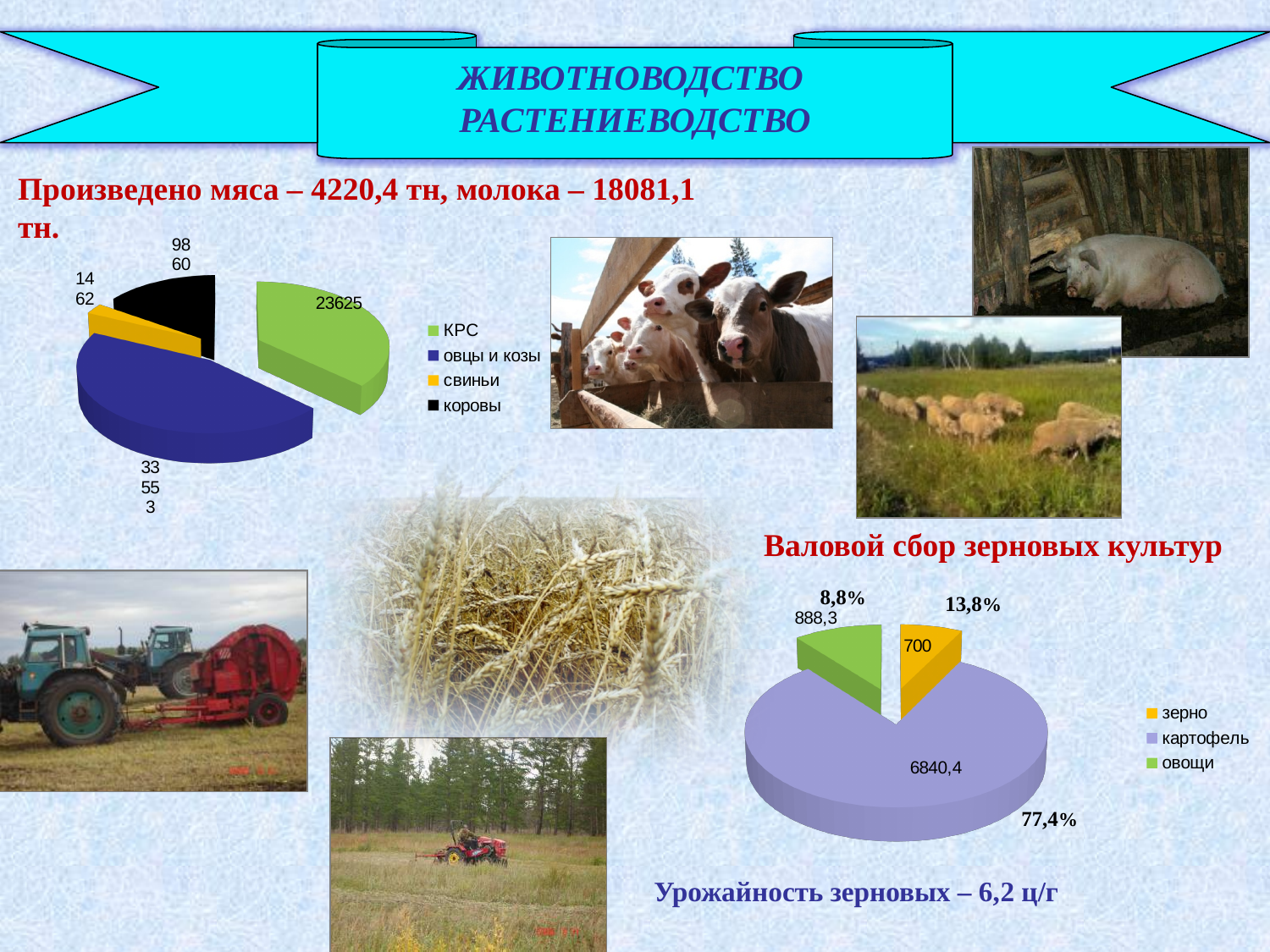
In the 'Валовой сбор зерновых культур' chart, which category is the largest? картофель In the left pie chart (livestock), which category has the smallest slice? свиньи In the 'Валовой сбор зерновых культур' chart, what share of the pie does картофель have? 77,4% How many categories does the legend of the 'Валовой сбор зерновых культур' chart list? 3 In the left pie chart (livestock), which category has the largest slice? овцы и козы In the 'Валовой сбор зерновых культур' chart, what is the value for овощи? 888,3 In the 'Валовой сбор зерновых культур' chart, which category is the smallest? зерно In the 'Валовой сбор зерновых культур' chart, what is the value for картофель? 6840,4 In the 'Валовой сбор зерновых культур' chart, what share of the pie does овощи have? 8,8% In the 'Валовой сбор зерновых культур' chart, what is the value for зерно? 700 What type of chart is used for 'Валовой сбор зерновых культур'? pie chart In the left pie chart (livestock), what is the value for КРС? 23625